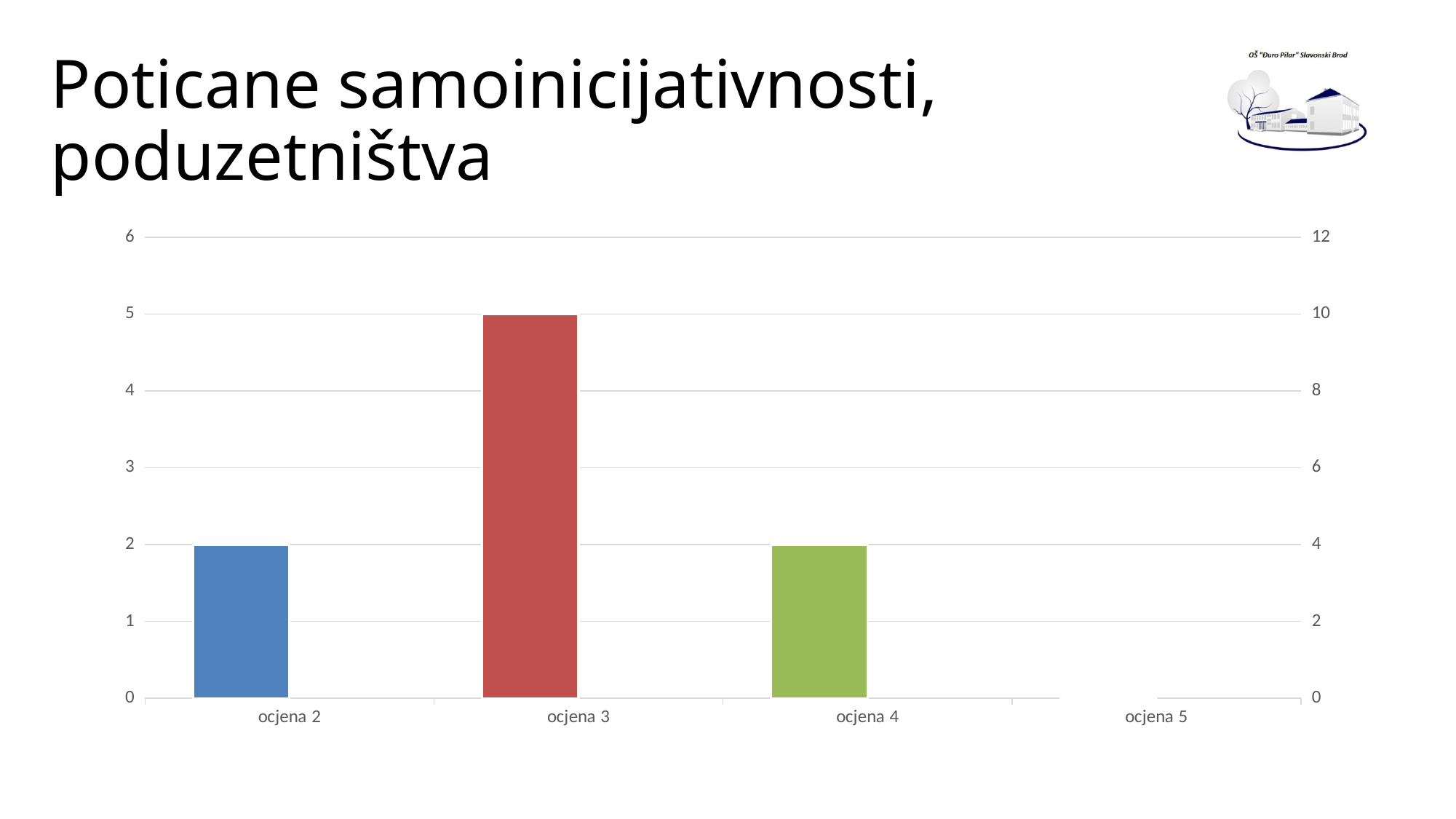
Is the value for ocjena 2 greater or less than 5? less Which is larger, the value for ocjena 4 or the value for ocjena 5? ocjena 4 What kind of chart is shown on the slide? bar chart Is the value for ocjena 3 greater or less than 4? greater Which is larger, the value for ocjena 3 or the value for ocjena 2? ocjena 3 Which category has the highest bar in the chart? ocjena 3 Is the value for ocjena 4 greater or less than 5? less What colour is the bar for ocjena 3? red Which category has the lowest value in the chart? ocjena 5 How many categories are shown on the x axis of the chart? 4 What is the title of the slide containing the chart? Poticane samoinicijativnosti, poduzetništva